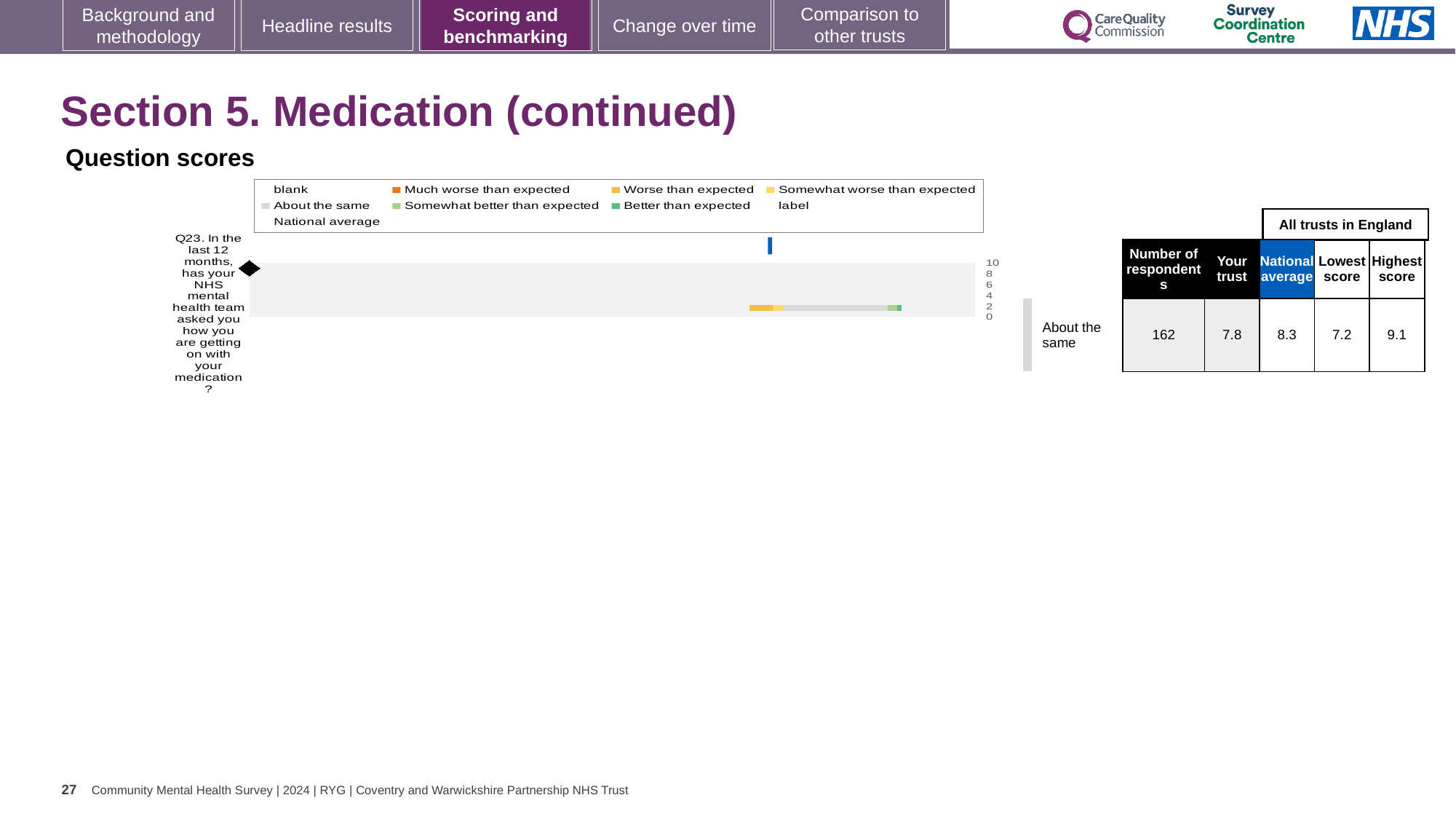
How many respondents answered Q23? 162 What is the difference between the highest score and the lowest score for Q23? 1.9 What is the national average score for Q23? 8.3 What is the lowest score among all trusts in England for Q23? 7.2 Which benchmarking category is Q23 assigned to? About the same By how much does the national average exceed the 'Your trust' score for Q23? 0.5 Which is larger for Q23, the 'Your trust' score or the national average? National average What is the maximum value shown on the chart's score axis? 10 What kind of chart is used to show the Q23 question score? bar chart What is the 'Your trust' score for Q23? 7.8 How many survey questions are plotted on the chart? 1 What is the highest score among all trusts in England for Q23? 9.1